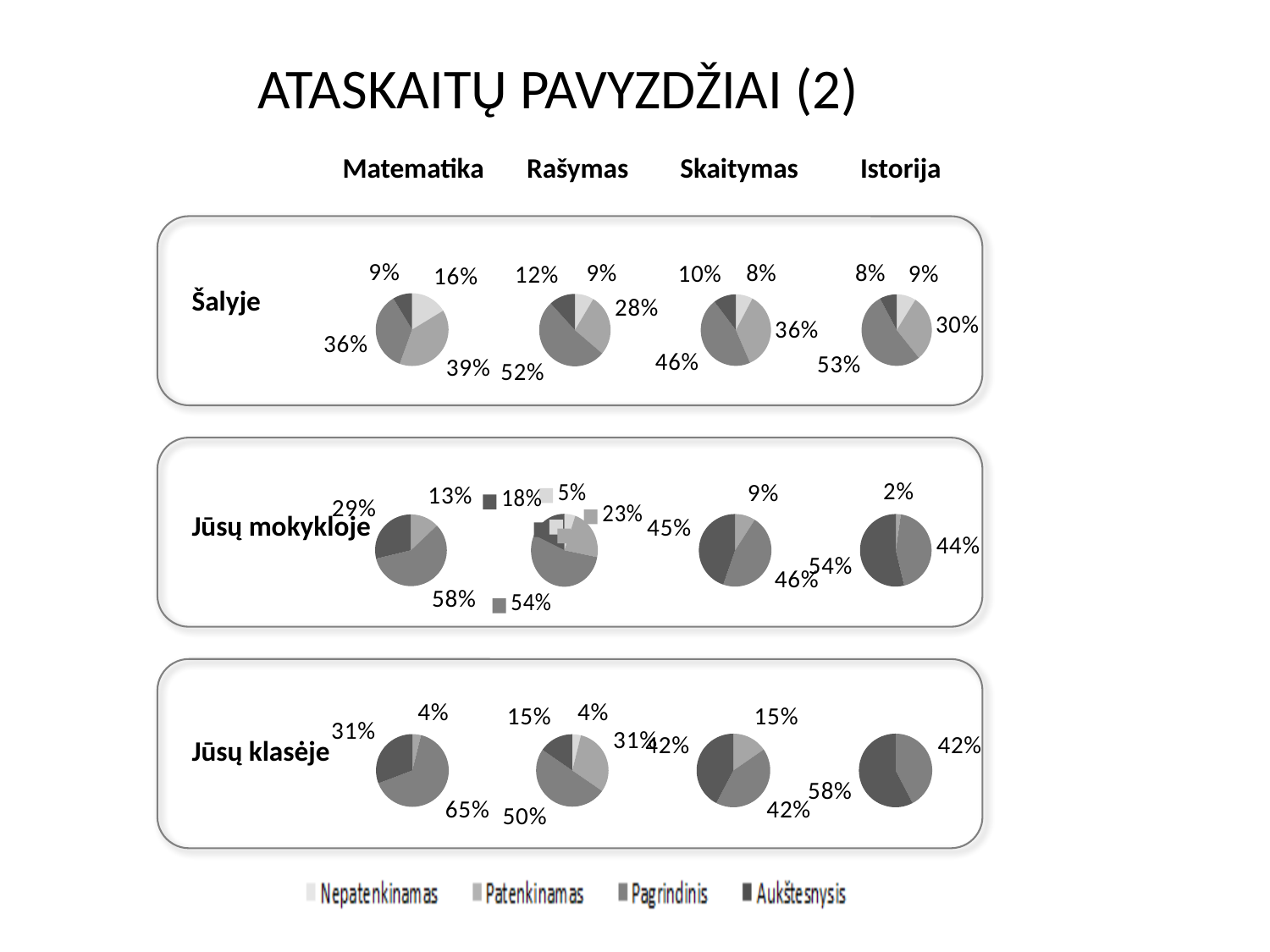
In the Šalyje row, what is the difference between the largest and smallest slices of the Istorija pie chart? 45% In the Šalyje row, what is the largest slice of the Istorija pie chart? 53% In the Šalyje row, what is the largest slice of the Matematika pie chart? 39% In the Šalyje row, what is the largest slice of the Rašymas pie chart? 52% How many pie charts are shown on the slide in total? 12 In the Šalyje row, what is the smallest slice of the Istorija pie chart? 8% What are the four subject column headings above the pie charts? Matematika, Rašymas, Skaitymas, Istorija In the Šalyje row, which pie chart has the larger biggest slice: Rašymas (52%) or Skaitymas (46%)? Rašymas How many categories does the legend at the bottom of the slide list? 4 What kind of charts are shown on the slide? Pie charts In the Jūsų mokykloje row, what is the smallest slice of the Istorija pie chart? 2%